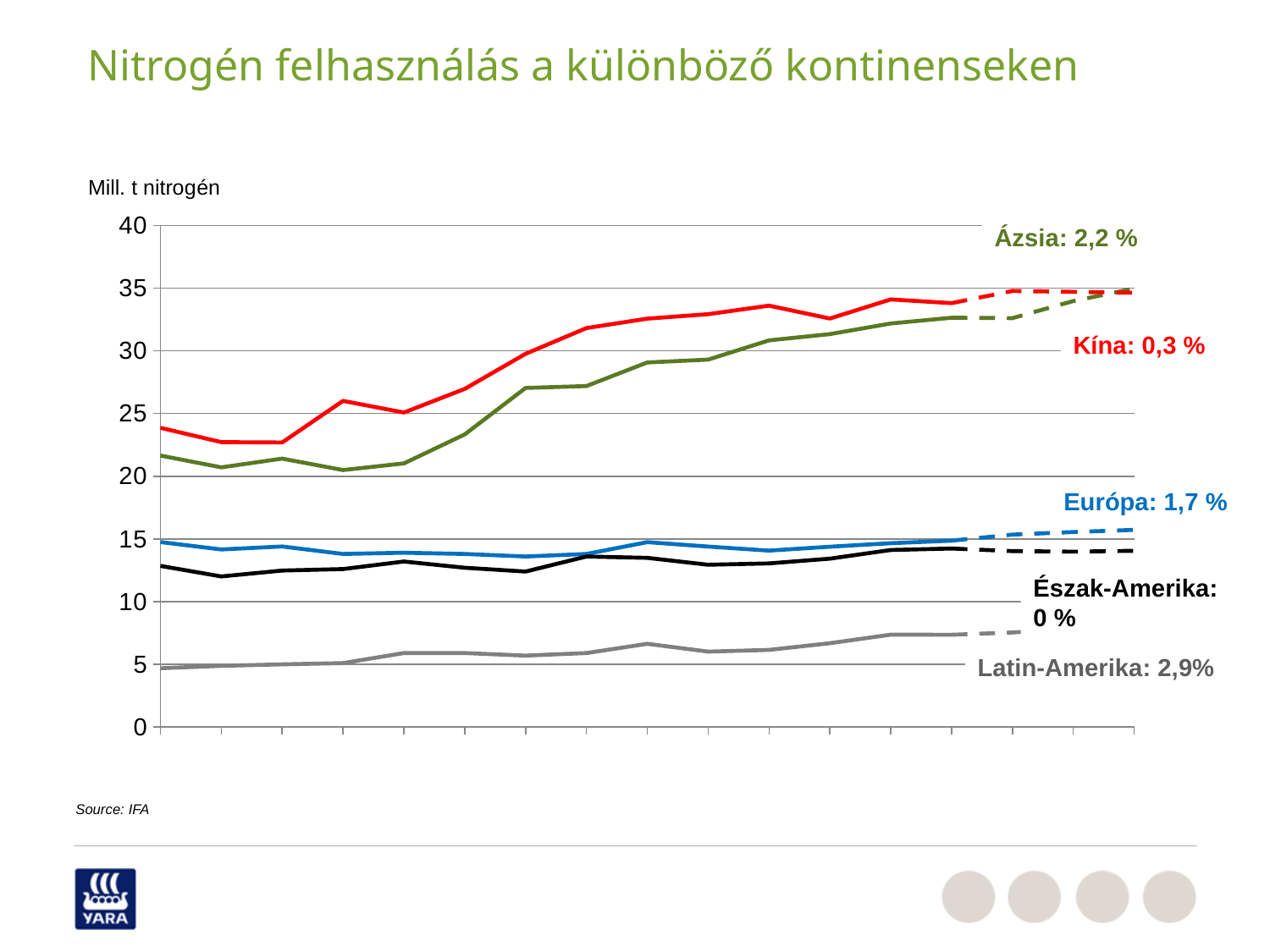
How many series (regions) are plotted on the chart? 5 Does the Ázsia line rise or fall along the x axis overall? rise Is the value for Európa at the end of the solid line greater or less than 20? less What unit is given for the y axis of the chart? Mill. t nitrogén Which region has the lowest line throughout the chart? Latin-Amerika Is the value for Latin-Amerika ever greater or less than 10? less What kind of chart is shown on the slide? line chart Is the value for Kína at the start of the chart greater or less than 20? greater What percentage is shown next to the Ázsia label? 2,2 % At the start of the chart, which is larger: the value for Európa or the value for Észak-Amerika? Európa Which region has the highest line at the start of the chart? Kína What percentage is shown next to the Észak-Amerika label? 0 %